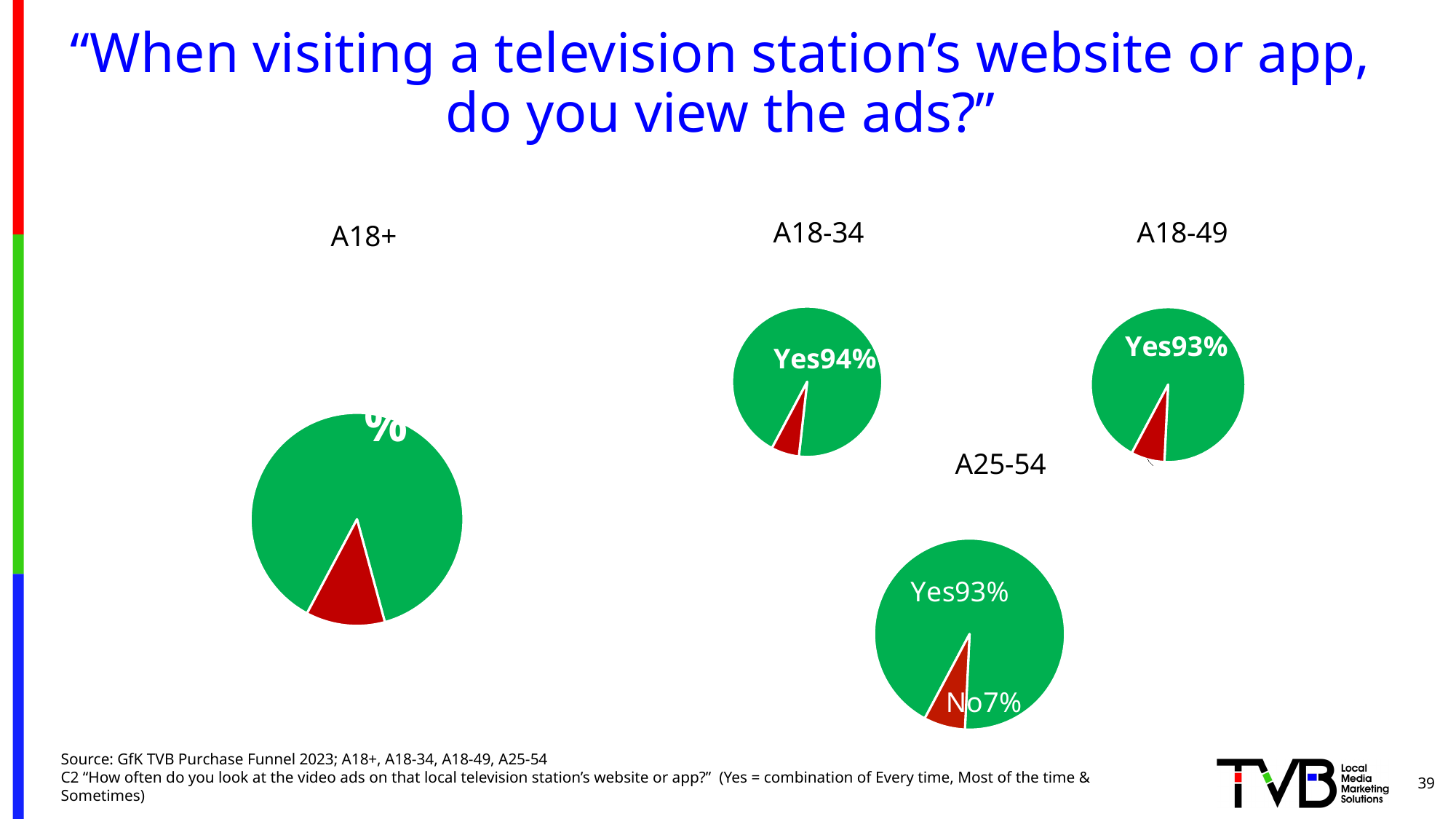
How many pie charts are shown on the slide? 4 What colour represents the Yes slice in the pie charts? Green How many slices does the A25-54 pie chart have? 2 In the A25-54 pie chart, what is the difference between the Yes and No percentages? 86 percentage points In the A25-54 pie chart, which slice is larger, Yes or No? Yes In the A25-54 pie chart, what percentage answered No? 7% In the A18-49 pie chart, what percentage answered Yes? 93% In the A25-54 pie chart, what percentage answered Yes? 93% In the A18-34 pie chart, what percentage answered Yes? 94% In the A25-54 pie chart, what do the Yes and No percentages add up to? 100% What kind of chart is used for the A18-34 group? Pie chart Which is larger: the Yes percentage for A18-34 or the Yes percentage for A18-49? A18-34